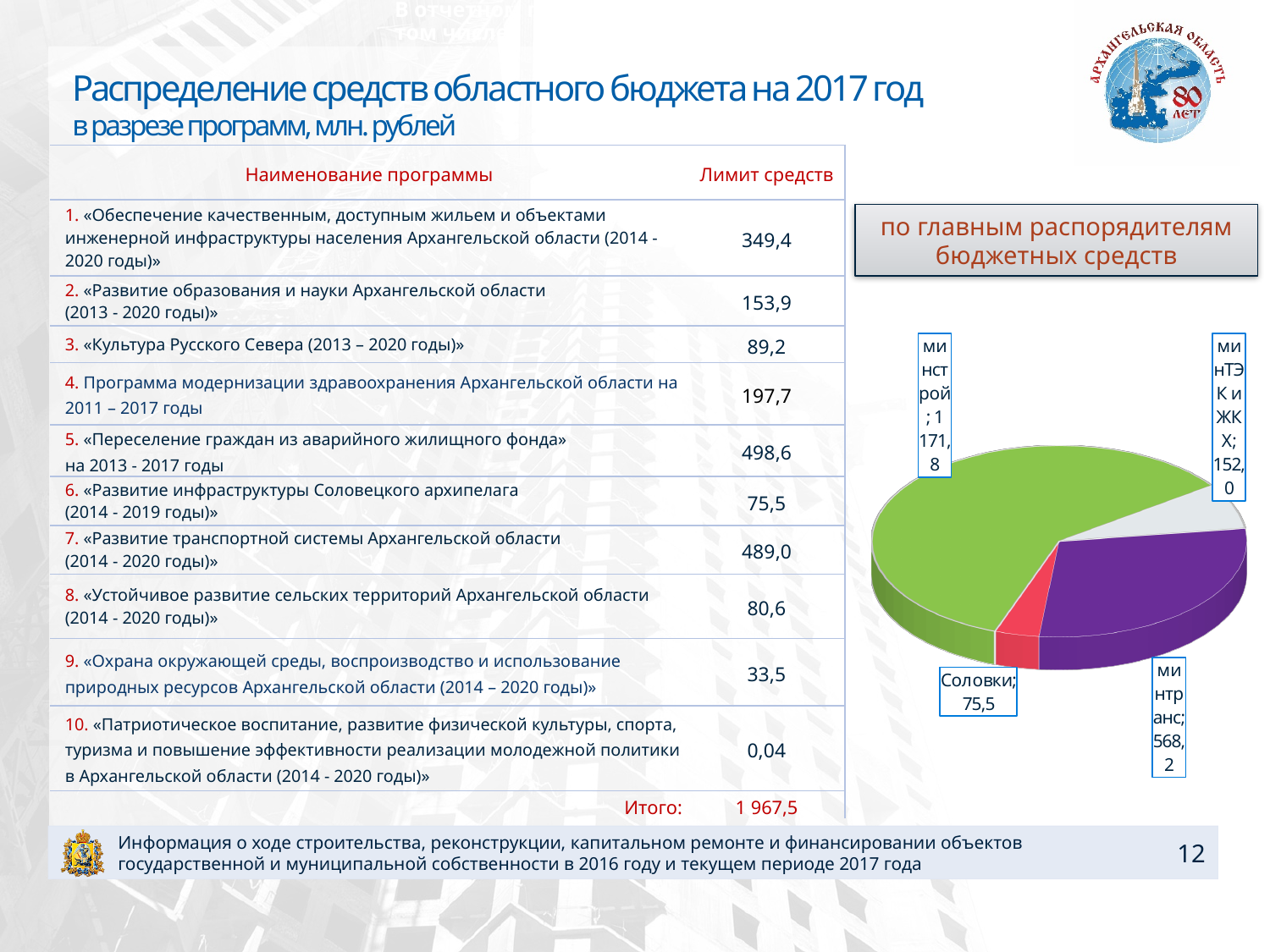
Which slice of the pie chart has the largest value? минстрой In the pie chart, what is the difference between the values for минстрой and минтранс? 603,6 What is the heading shown above the pie chart? по главным распорядителям бюджетных средств In the pie chart, which is larger: the value for минтранс or the value for минТЭК и ЖКХ? минтранс In the pie chart, what is the value for минстрой? 1 171,8 Which slice of the pie chart has the smallest value? Соловки In the pie chart, what is the value for минТЭК и ЖКХ? 152,0 In the pie chart, what is the value for минтранс? 568,2 In the pie chart, what is the value for Соловки? 75,5 In the pie chart, what is the difference between the values for минТЭК и ЖКХ and Соловки? 76,5 What kind of chart is shown on the right side of the slide? pie chart How many slices does the pie chart have? 4